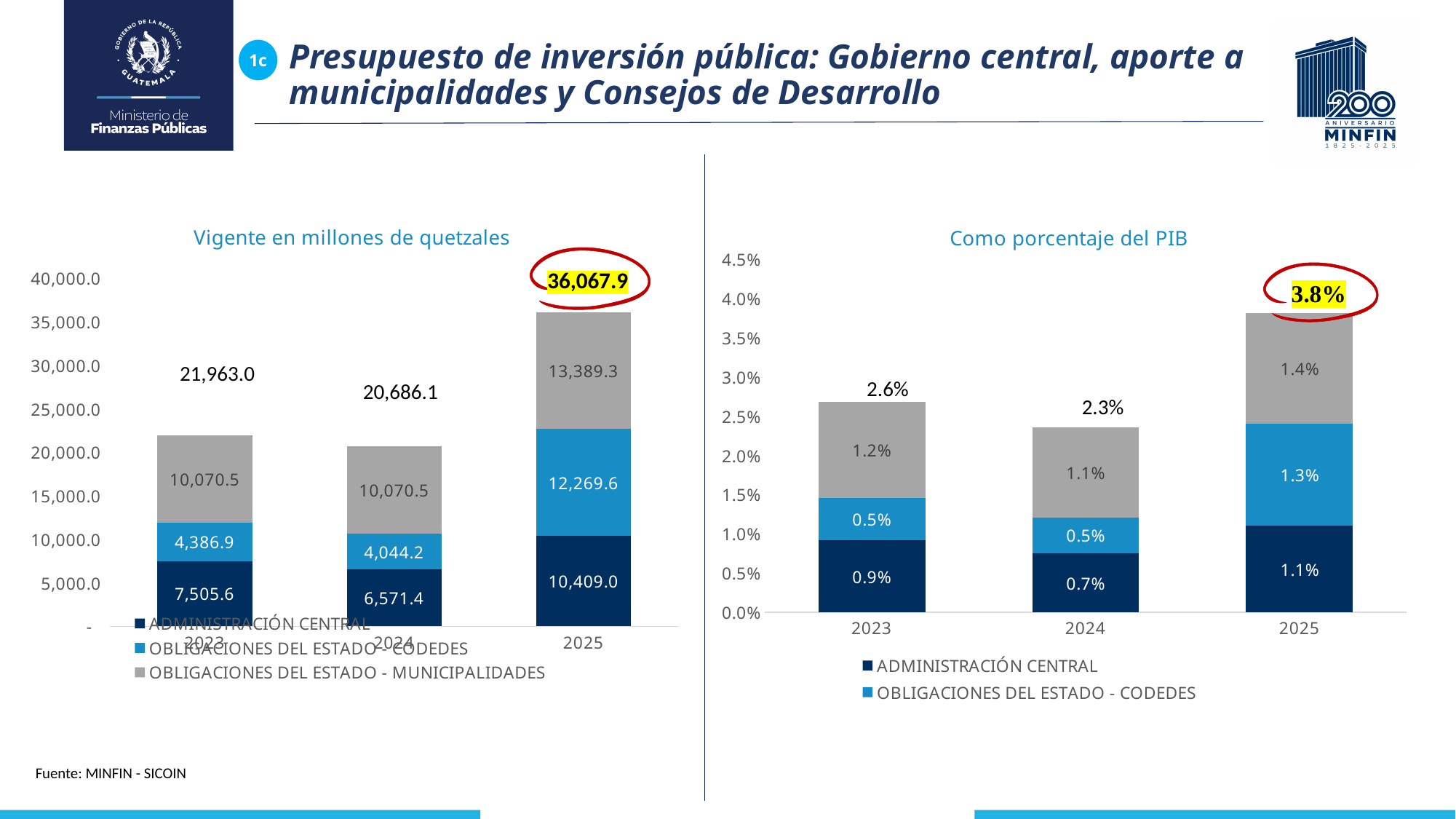
In the chart 'Como porcentaje del PIB', is the ADMINISTRACIÓN CENTRAL value larger in 2023 or in 2024? 2023 In the chart 'Vigente en millones de quetzales', how many series does the legend list? 3 In the chart 'Vigente en millones de quetzales', which year has the lowest total? 2024 In the chart 'Vigente en millones de quetzales', what is the value for OBLIGACIONES DEL ESTADO - CODEDES in 2024? 4,044.2 In the chart 'Como porcentaje del PIB', which year has the highest total? 2025 In the chart 'Vigente en millones de quetzales', what is the difference between the OBLIGACIONES DEL ESTADO - MUNICIPALIDADES values for 2025 and 2024? 3,318.8 What kind of chart is 'Como porcentaje del PIB'? Stacked bar chart In the chart 'Vigente en millones de quetzales', what is the value for ADMINISTRACIÓN CENTRAL in 2025? 10,409.0 In the chart 'Como porcentaje del PIB', what is the total of the stacked bar for 2023? 2.6% In the chart 'Vigente en millones de quetzales', what is the total of the stacked bar for 2025? 36,067.9 In the chart 'Como porcentaje del PIB', how many years are shown on the x axis? 3 In the chart 'Como porcentaje del PIB', what is the value for OBLIGACIONES DEL ESTADO - CODEDES in 2025? 1.3%